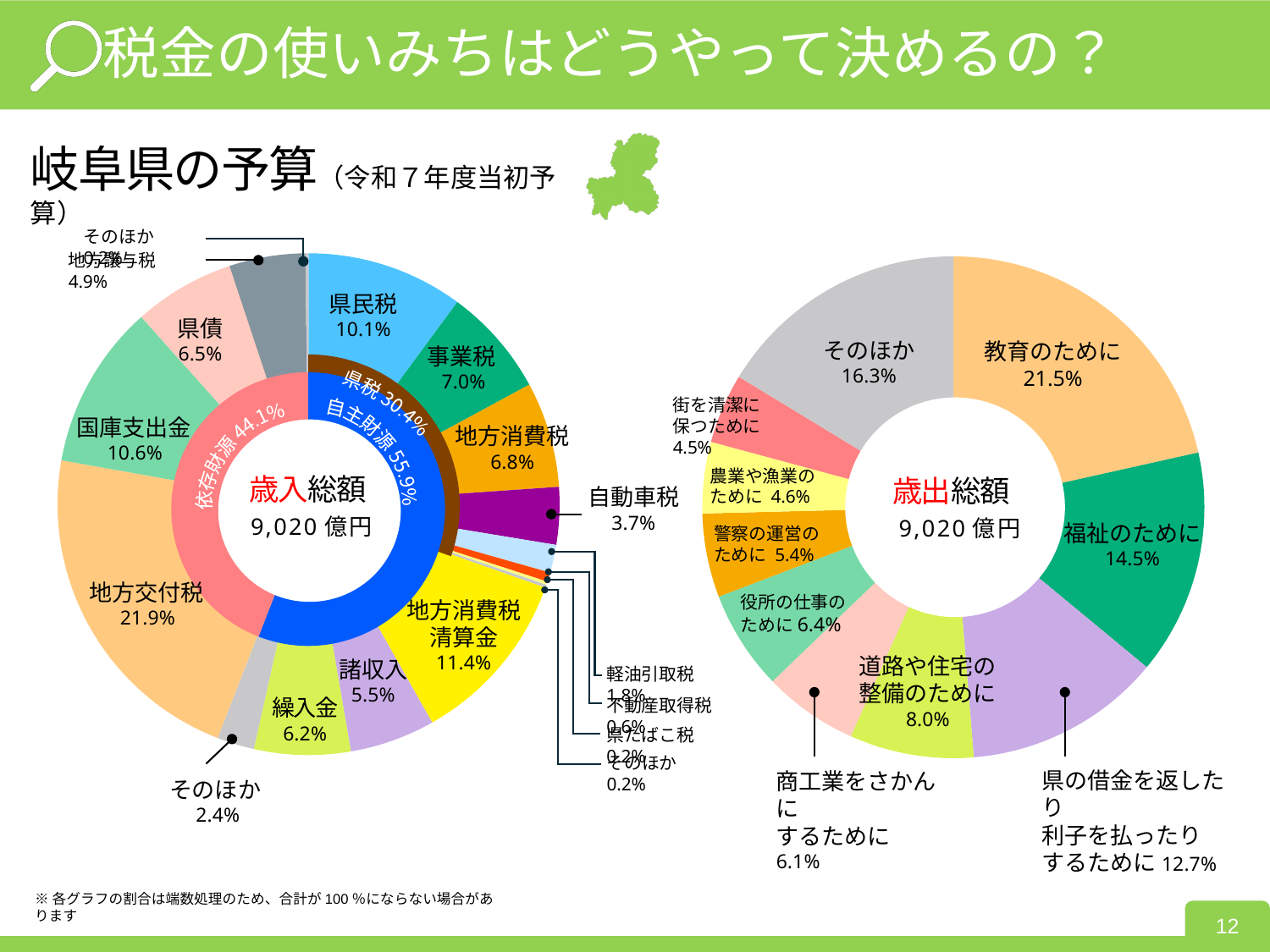
In the 歳入総額 chart on the left, what percentage is shown for 自主財源 in the inner ring? 55.9% What type of chart is used for the 歳入総額 chart on the left? Donut (pie) chart In the 歳入総額 chart on the left, which labelled category has the largest share? 地方交付税 In the 歳出総額 chart on the right, what is the share for 教育のために? 21.5% In the 歳出総額 chart on the right, what is the difference between 道路や住宅の整備のために and 商工業をさかんにするために? 1.9% What total amount is shown in the centre of the 歳出総額 chart on the right? 9,020 億円 In the 歳入総額 chart on the left, what is the share for 県民税? 10.1% In the 歳出総額 chart on the right, what is the share for 福祉のために? 14.5% In the 歳入総額 chart on the left, what is the share for 地方交付税? 21.9% In the 歳出総額 chart on the right, which labelled purpose has the smallest share? 街を清潔に保つために In the 歳入総額 chart on the left, what is the difference between 地方消費税清算金 and 諸収入? 5.9% In the 歳入総額 chart on the left, which is larger, 国庫支出金 or 県債? 国庫支出金